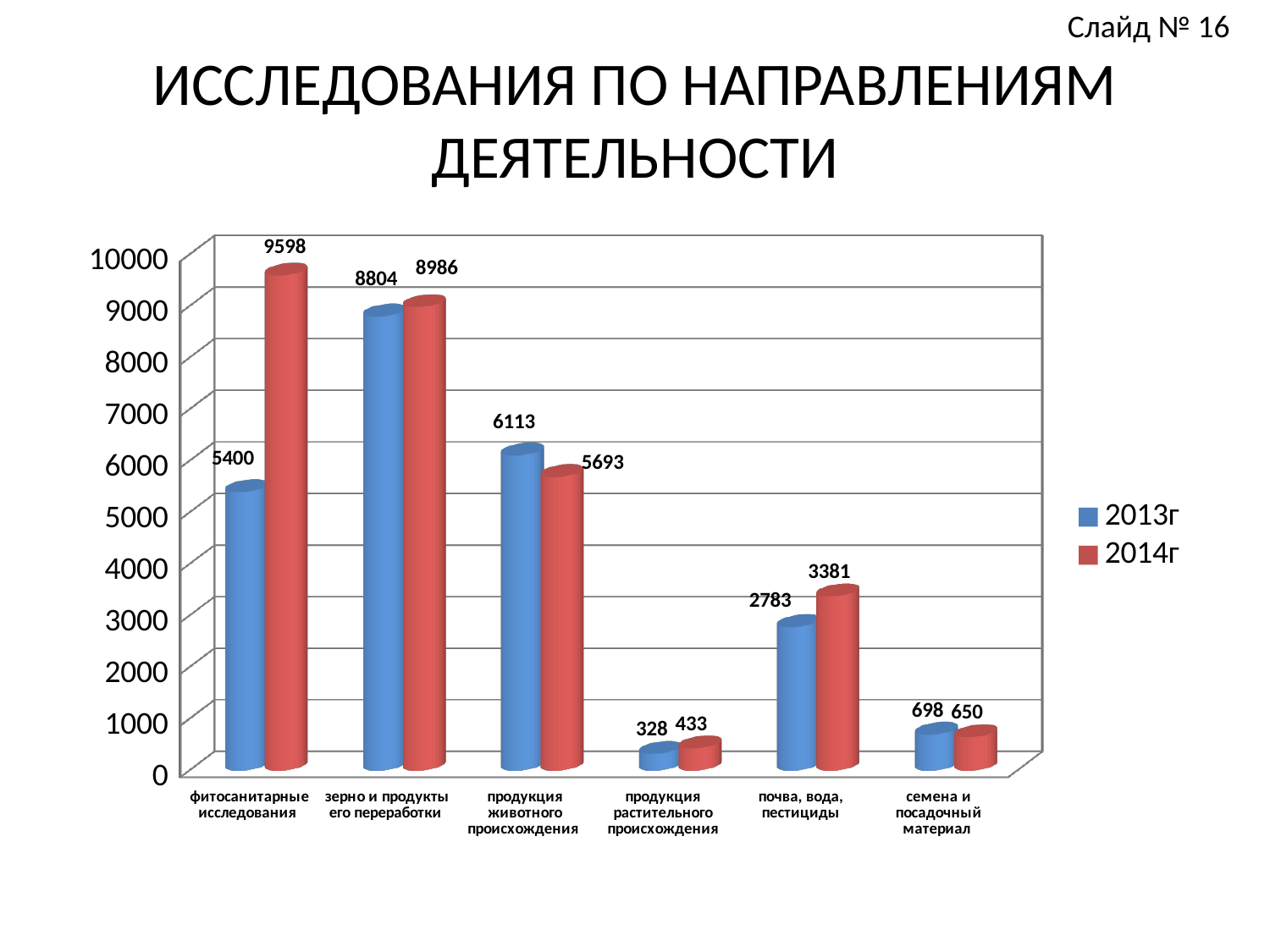
What kind of chart is shown on the slide? bar chart What is the value for фитосанитарные исследования in 2014г? 9598 Which category has the lowest value in 2013г? продукция растительного происхождения How many series does the legend list? 2 What is the difference between the 2013г and 2014г values for семена и посадочный материал? 48 Which is larger for продукция животного происхождения: the 2013г value or the 2014г value? 2013г Is the 2013г value for почва, вода, пестициды greater or less than 3000? less What is the value for почва, вода, пестициды in 2014г? 3381 What is the difference between the 2014г and 2013г values for фитосанитарные исследования? 4198 What is the value for зерно и продукты его переработки in 2013г? 8804 How many categories are shown on the x axis? 6 Which category has the highest value in 2014г? фитосанитарные исследования